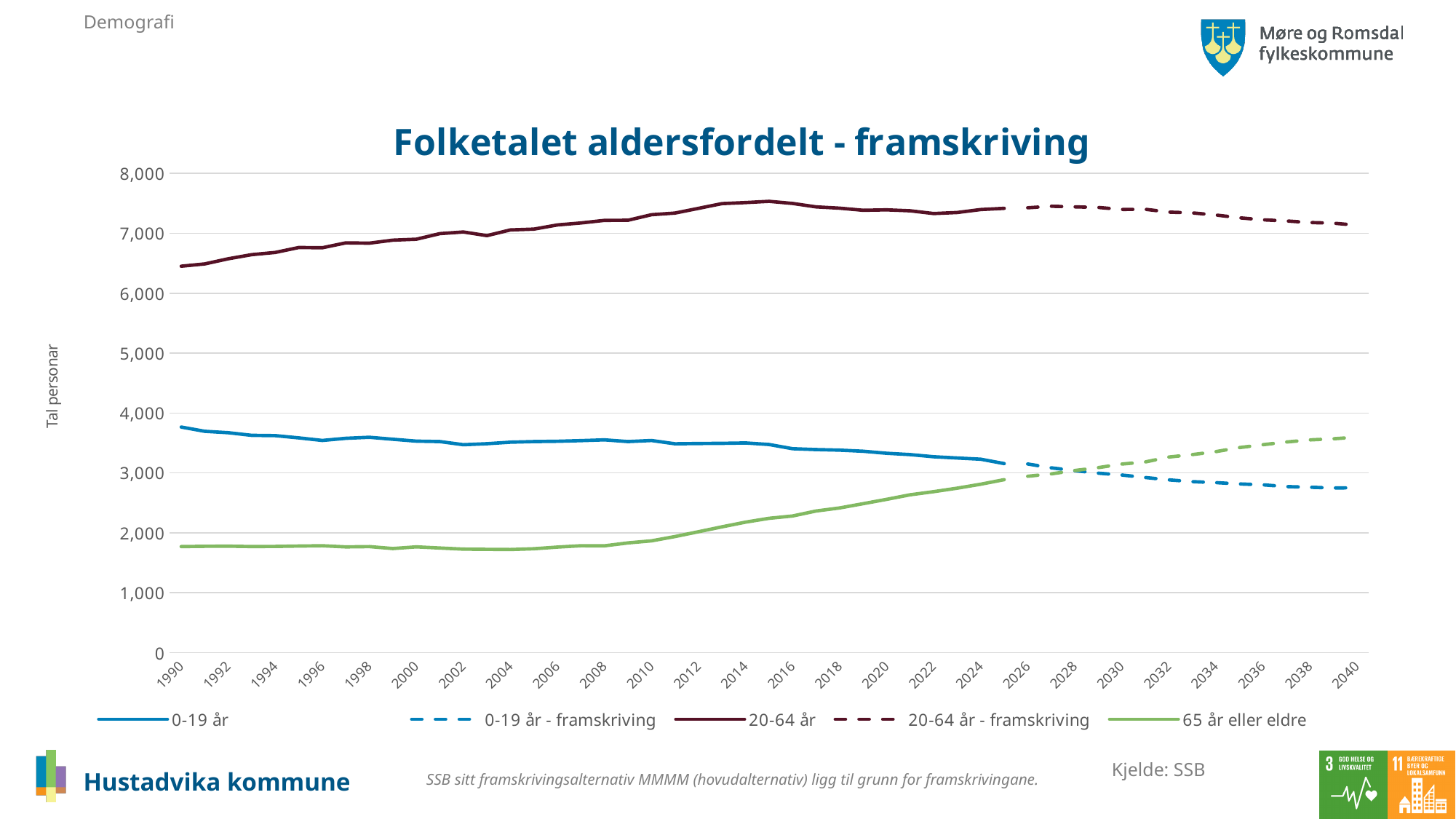
Is the value for 20-64 år in 1990 greater or less than 6,000? greater Is the value for 65 år eller eldre in 1990 greater or less than 2,000? less What is the title of the chart? Folketalet aldersfordelt - framskriving What is the label on the vertical axis? Tal personar Which series has the highest value in 2020? 20-64 år What kind of chart is shown on the slide? Line chart Is the value for 20-64 år in 2014 greater or less than 7,000? greater Does the 65 år eller eldre line rise or fall between 2010 and 2024? Rises Does the 0-19 år line rise or fall between 1990 and 2024? Falls How many series does the legend list? 5 In 1990, which is larger: 0-19 år or 65 år eller eldre? 0-19 år